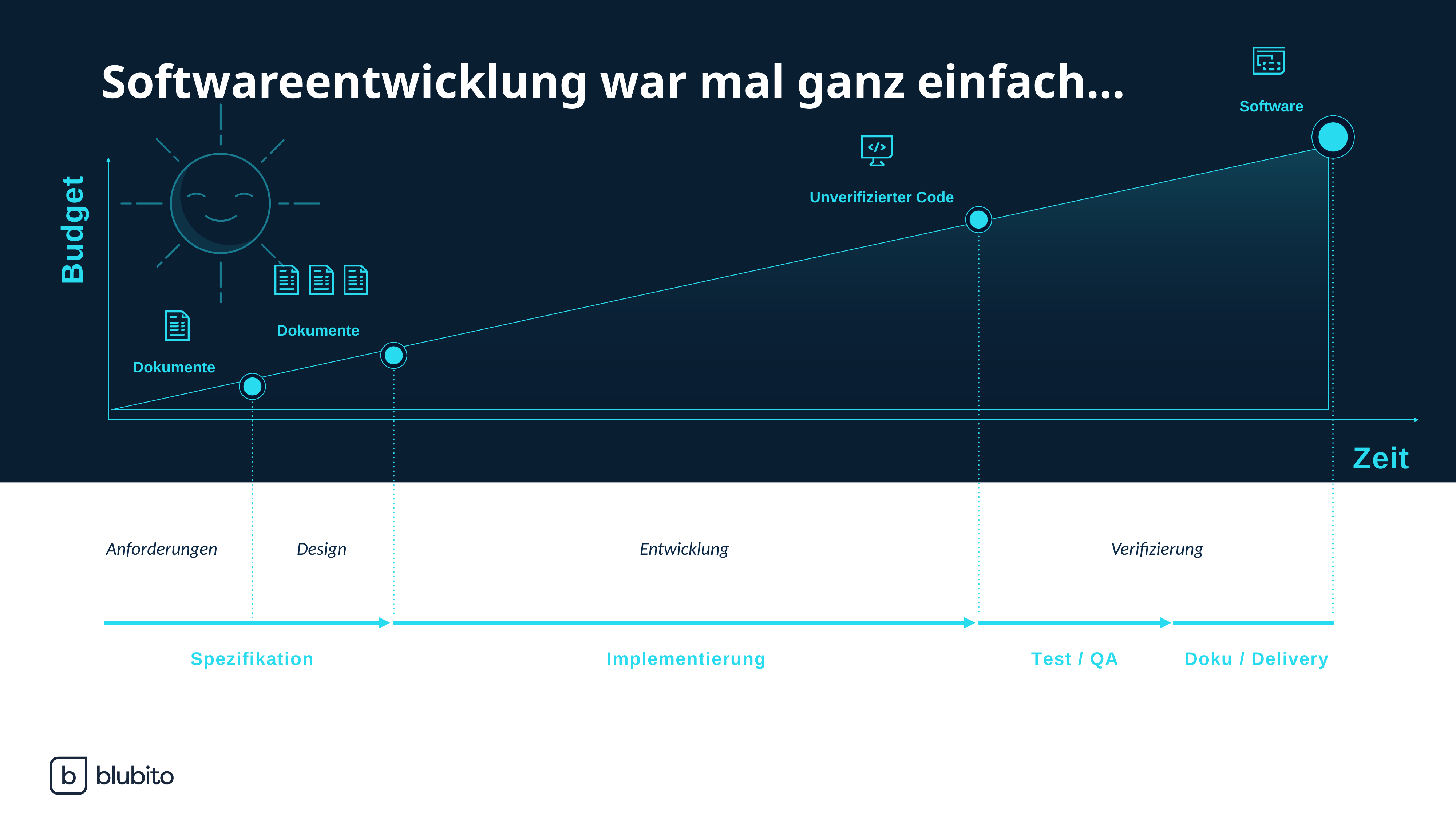
Which point is higher on the Budget axis, Unverifizierter Code or Software? Software Which marked point on the line has the lowest budget value? Dokumente (first point) Which marked point on the line has the highest budget value? Software Does the plotted line rise or fall along the x axis? rise What is the label of the vertical axis? Budget Which point is higher on the Budget axis, the second Dokumente point or Unverifizierter Code? Unverifizierter Code What is the label of the horizontal axis? Zeit How many marked points are on the plotted line? 4 Which phase label on the timeline corresponds to the point labelled Unverifizierter Code? Implementierung What kind of chart is shown on the slide? area chart